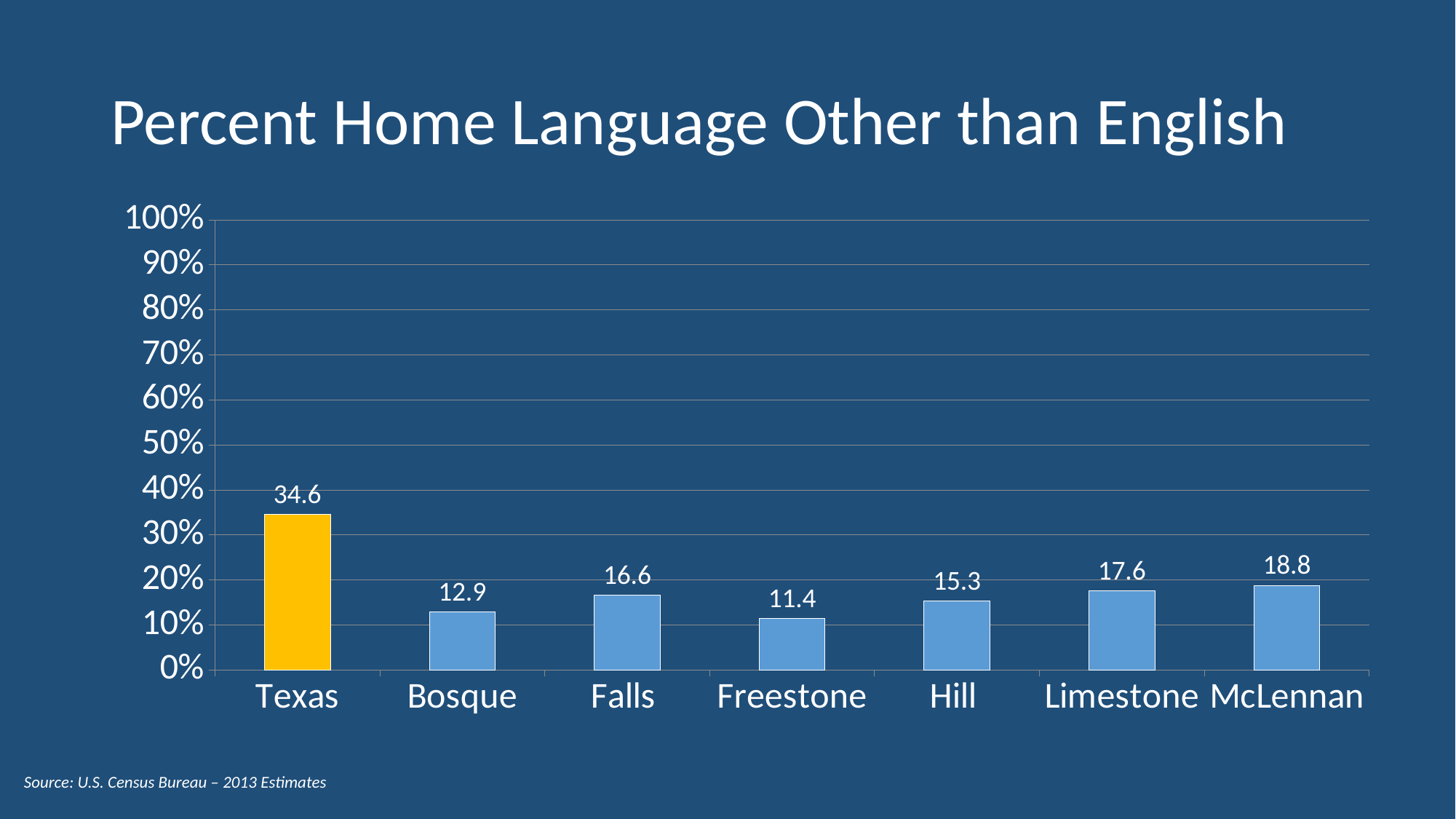
Which category has the lowest value? Freestone What is the difference between the values for Limestone and Bosque? 4.7 What is the title of the chart? Percent Home Language Other than English What is the value for McLennan? 18.8 Which is larger, the value for Falls or the value for Hill? Falls What is the value for Texas? 34.6 What is the value for Freestone? 11.4 What kind of chart is shown on the slide? Bar chart What is the difference between the values for Texas and McLennan? 15.8 How many categories are shown on the x axis? 7 Is the value for Texas greater or less than 30%? greater Which category has the highest value? Texas